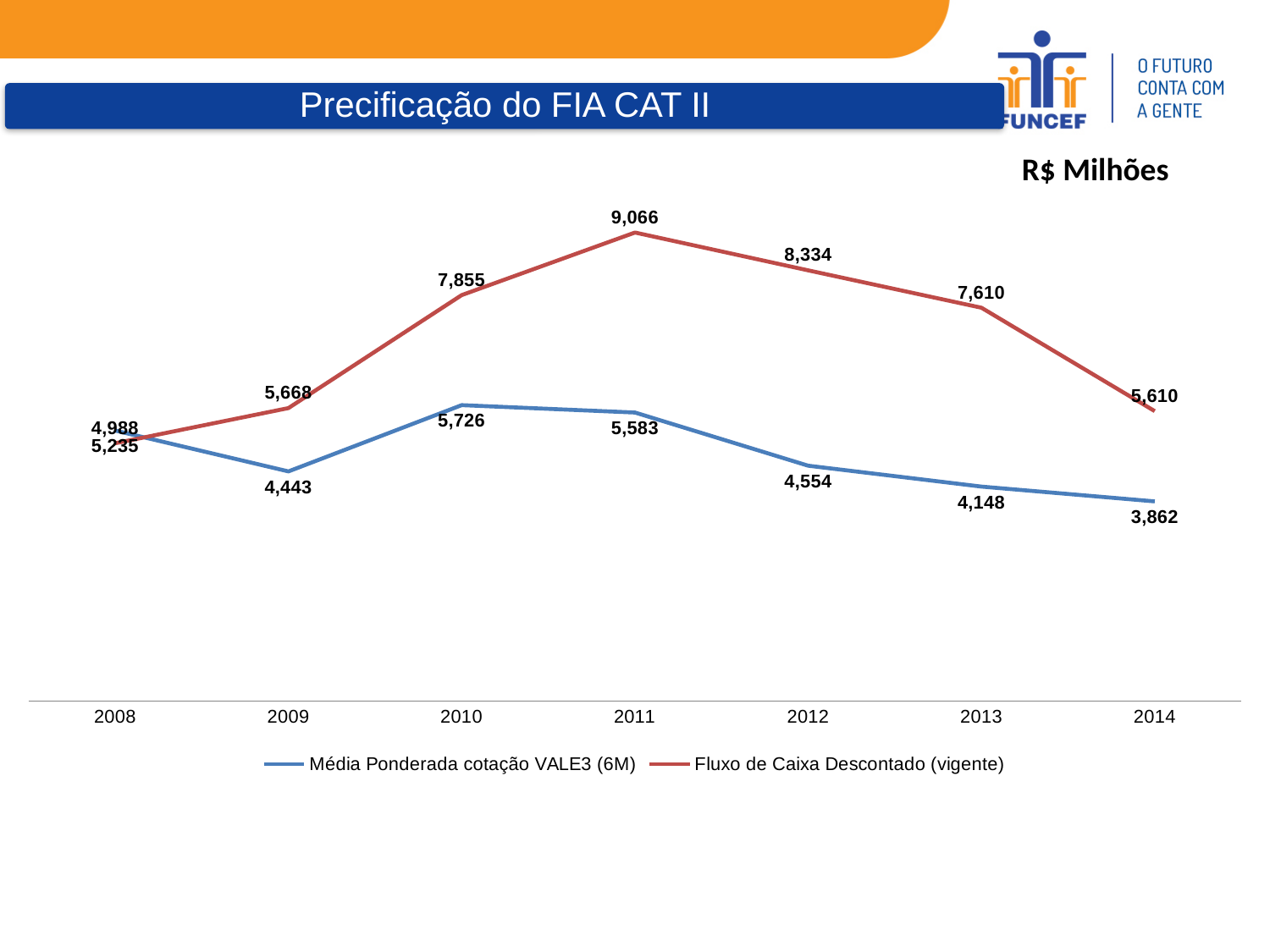
In 2010, which series has the higher value: Média Ponderada cotação VALE3 (6M) or Fluxo de Caixa Descontado (vigente)? Fluxo de Caixa Descontado (vigente) What kind of chart is shown on the slide? Line chart What is the value of Média Ponderada cotação VALE3 (6M) in 2014? 3,862 By how much did Fluxo de Caixa Descontado (vigente) fall from 2013 to 2014? 2,000 In which year is Média Ponderada cotação VALE3 (6M) at its lowest? 2014 What is the value of Fluxo de Caixa Descontado (vigente) in 2011? 9,066 In which year does Fluxo de Caixa Descontado (vigente) reach its highest value? 2011 How many years are shown on the x axis of the chart? 7 What is the difference between Fluxo de Caixa Descontado (vigente) and Média Ponderada cotação VALE3 (6M) in 2011? 3,483 Does Média Ponderada cotação VALE3 (6M) rise or fall from 2011 to 2014? Fall How many series does the legend list? 2 What is the value of Média Ponderada cotação VALE3 (6M) in 2010? 5,726